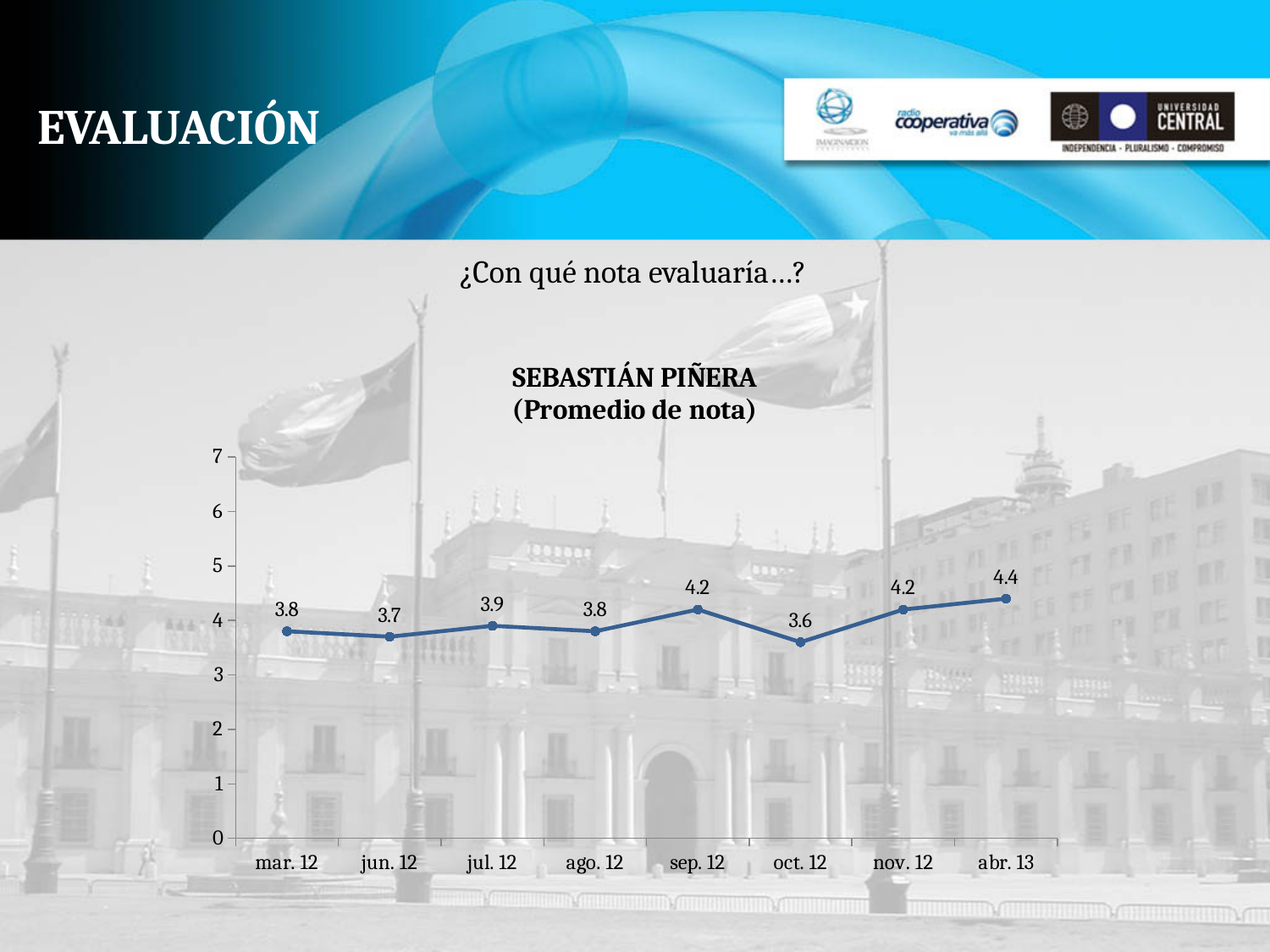
How many periods are shown on the x axis? 8 Is the value for nov. 12 greater or less than 4? greater What is the value for abr. 13? 4.4 What is the difference between the values for abr. 13 and oct. 12? 0.8 What is the value for oct. 12? 3.6 What kind of chart is shown? line chart What is the value for mar. 12? 3.8 What is the title of the chart? SEBASTIÁN PIÑERA (Promedio de nota) Which period has the lowest value? oct. 12 Which is larger, the value for sep. 12 or the value for jun. 12? sep. 12 Which period has the highest value? abr. 13 What is the value for jul. 12? 3.9